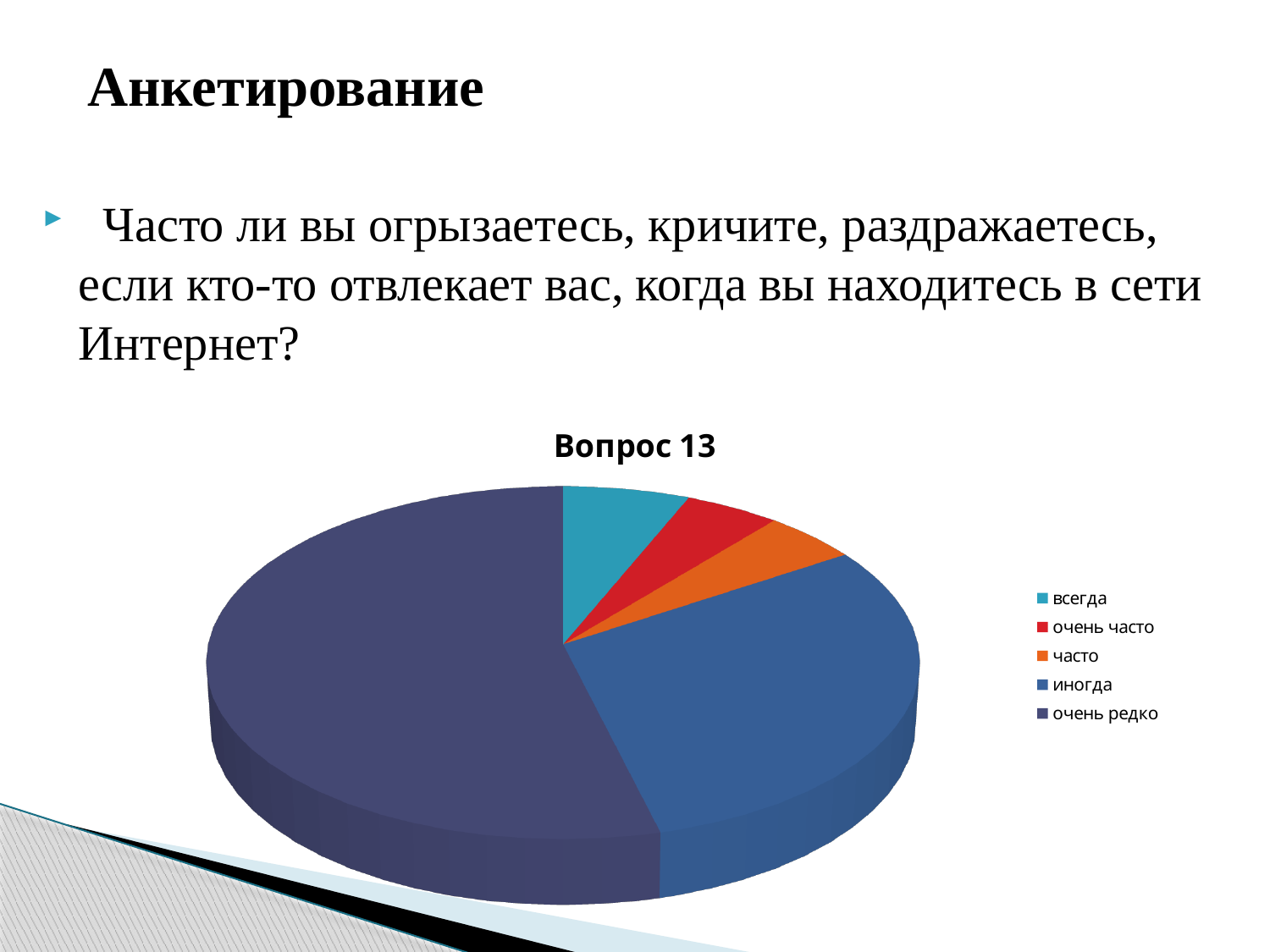
How many entries does the chart legend list? 5 Which category has the largest slice of the pie? очень редко How many categories does the pie chart have? 5 Which slice is larger, "очень редко" or "иногда"? очень редко Which slice is larger, "всегда" or "иногда"? иногда What kind of chart is shown on the slide? pie chart Which category is shown in red in the legend? очень часто Which slice is larger, "часто" or "очень редко"? очень редко What is the title of the chart? Вопрос 13